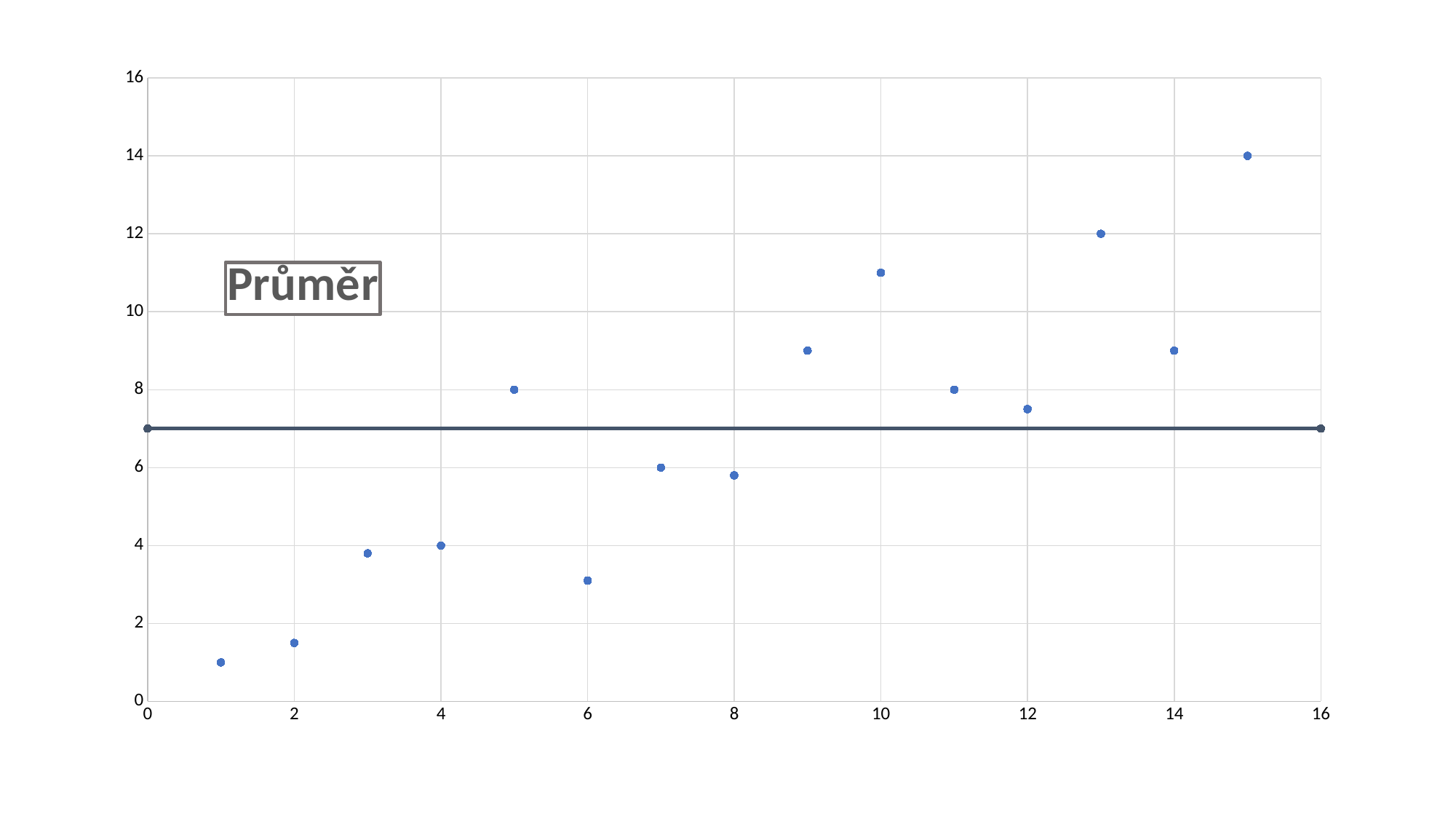
What is the y value of the point at x = 13? 12 Which point has the larger y value, the one at x = 9 or the one at x = 8? x = 9 What is the text label shown next to the horizontal line on the chart? Průměr Is the y value of the point at x = 6 greater or less than 4? less What is the y value of the point at x = 5? 8 What kind of chart is shown on the slide? scatter chart How many blue data points are plotted on the chart? 15 At which x value is the lowest point plotted? 1 At which x value is the highest point plotted? 15 What is the y value of the point at x = 15? 14 Is the y value of the point at x = 10 greater or less than 10? greater What is the y value of the point at x = 4? 4